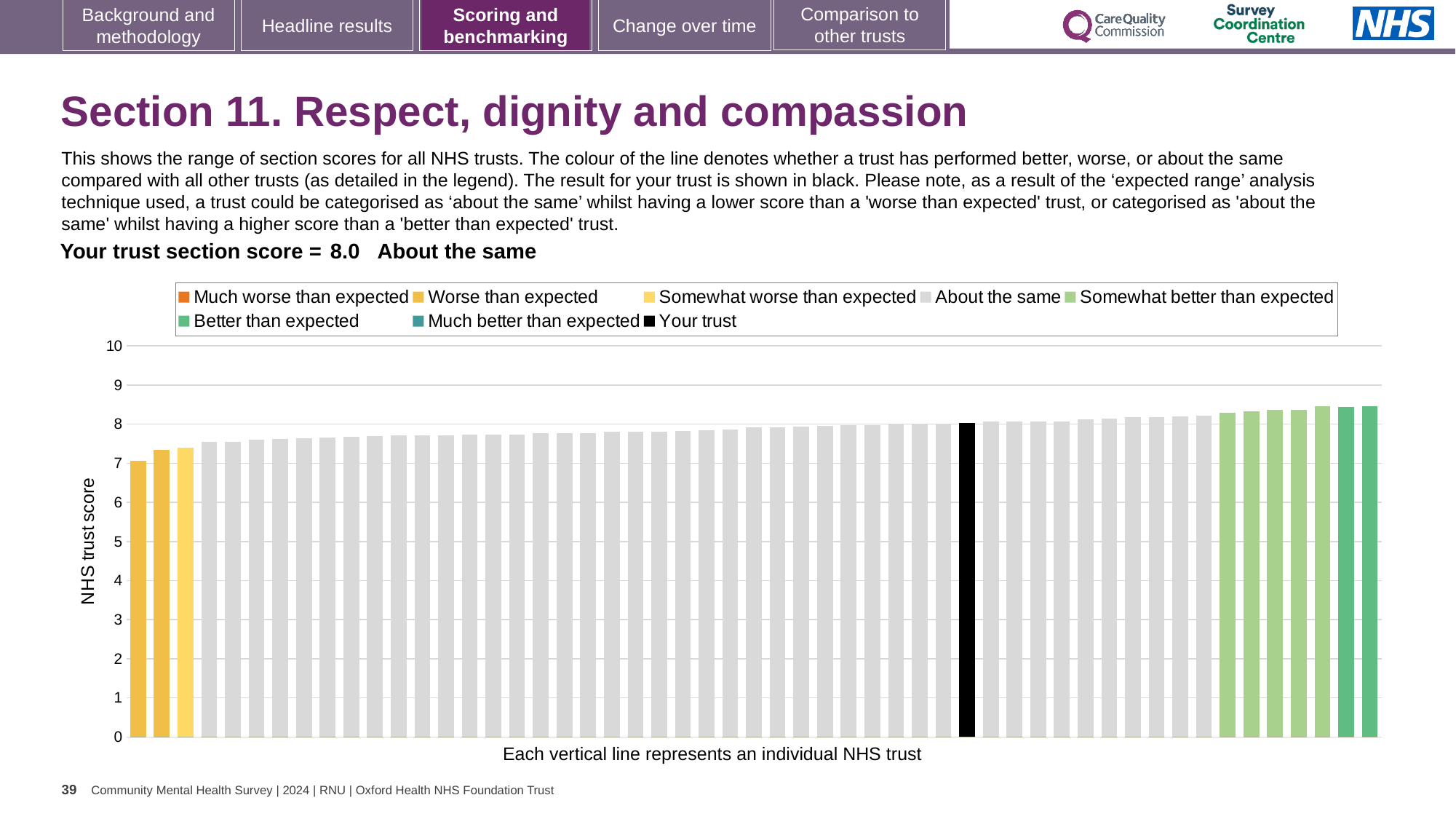
What kind of chart is shown on the slide? bar chart What is the section score for your trust? 8.0 How many entries does the chart legend list? 8 Is the value for your trust greater or less than 5? greater Is the value of the highest-scoring trust greater or less than 8? greater Which performance category is your trust placed in for this section? About the same What colour is the bar representing your trust? black Is the value of the lowest-scoring trust greater or less than 6? greater Do the trust scores rise or fall from left to right along the x axis? rise Is the leftmost bar higher or lower than the bar for your trust? lower What is the label on the vertical axis of the chart? NHS trust score